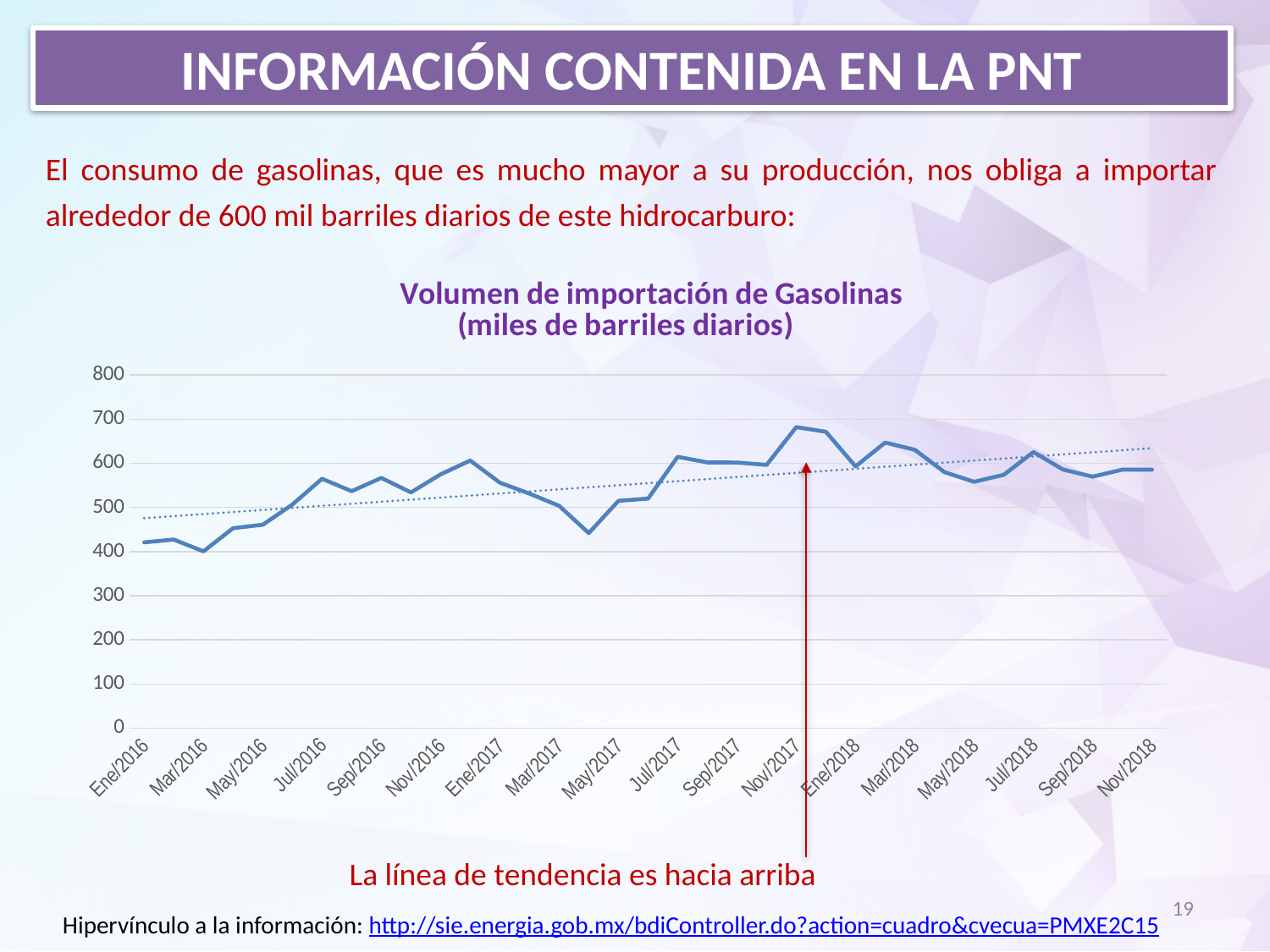
Is the value for Ene/2016 greater or less than 500? less Is the value for Nov/2017 greater or less than 600? greater How many month labels are shown on the x axis? 18 Which is larger, the value for Nov/2017 or the value for Ene/2016? Nov/2017 What is the highest value shown on the y axis? 800 What kind of chart is shown on the slide? line chart Is the value for Mar/2018 greater or less than 600? greater What is the title of the chart? Volumen de importación de Gasolinas (miles de barriles diarios) Which is larger, the value for Mar/2016 or the value for Jul/2016? Jul/2016 According to the chart and the slide's annotation, is the overall trend of gasoline import volume rising or falling over time? rising